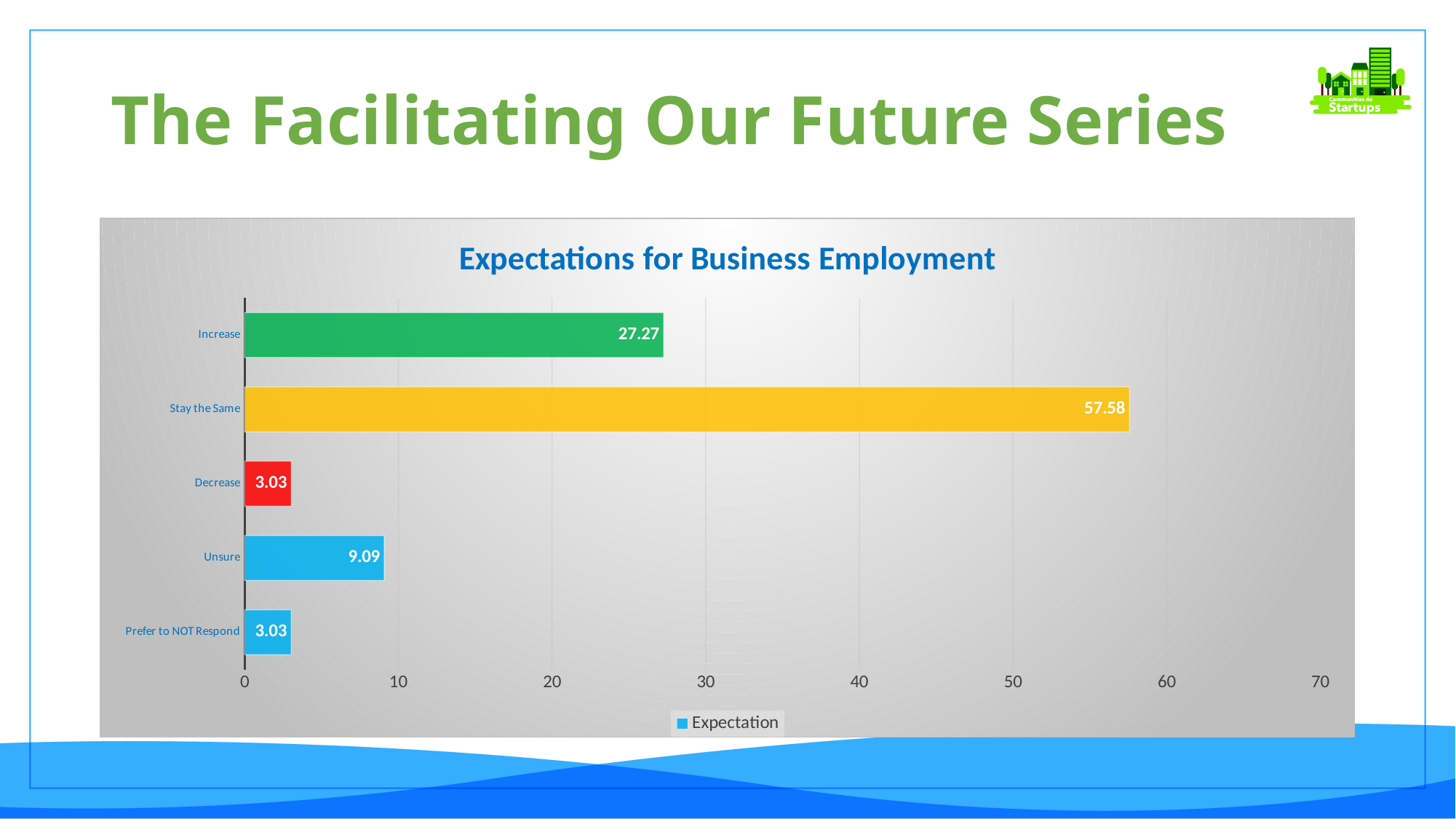
What is the difference between the values for Unsure and Decrease? 6.06 What is the value for Stay the Same? 57.58 What kind of chart is shown on the slide? bar chart Which category has the highest value? Stay the Same What is the value for Decrease? 3.03 What is the value for Increase? 27.27 What is the difference between the values for Stay the Same and Increase? 30.31 What is the title of the chart? Expectations for Business Employment What is the value for Unsure? 9.09 Which is larger, the value for Increase or the value for Unsure? Increase Is the value for Stay the Same greater or less than 50? greater How many categories are shown in the chart? 5